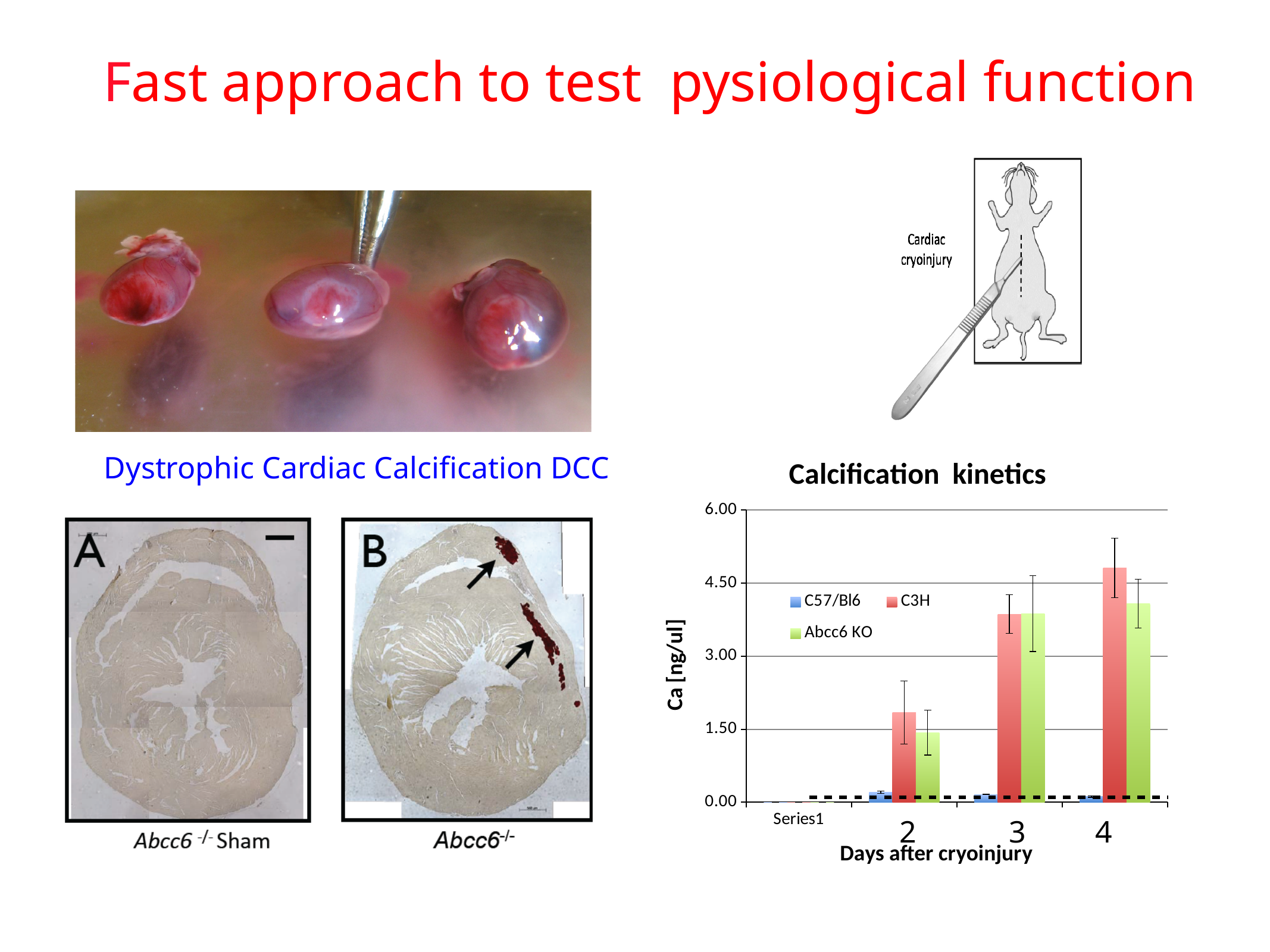
In the "Calcification kinetics" chart, is the C3H value at day 2 greater or less than 1.50? greater In the "Calcification kinetics" chart, is the Abcc6 KO value at day 3 greater or less than 3.00? greater How many series does the legend of the "Calcification kinetics" chart list? 3 Which series are listed in the legend of the "Calcification kinetics" chart? C57/Bl6, C3H, Abcc6 KO In the "Calcification kinetics" chart, which series has the lowest values across all days? C57/Bl6 In the "Calcification kinetics" chart, is the C3H value at day 4 greater or less than 4.50? greater In the "Calcification kinetics" chart, which series is larger at day 4, C3H or Abcc6 KO? C3H What kind of chart is the "Calcification kinetics" chart? bar chart What is the y-axis label of the "Calcification kinetics" chart? Ca [ng/ul] In the "Calcification kinetics" chart, do the C3H values rise or fall from day 2 to day 4? rise How many categories are shown along the x axis of the "Calcification kinetics" chart? 4